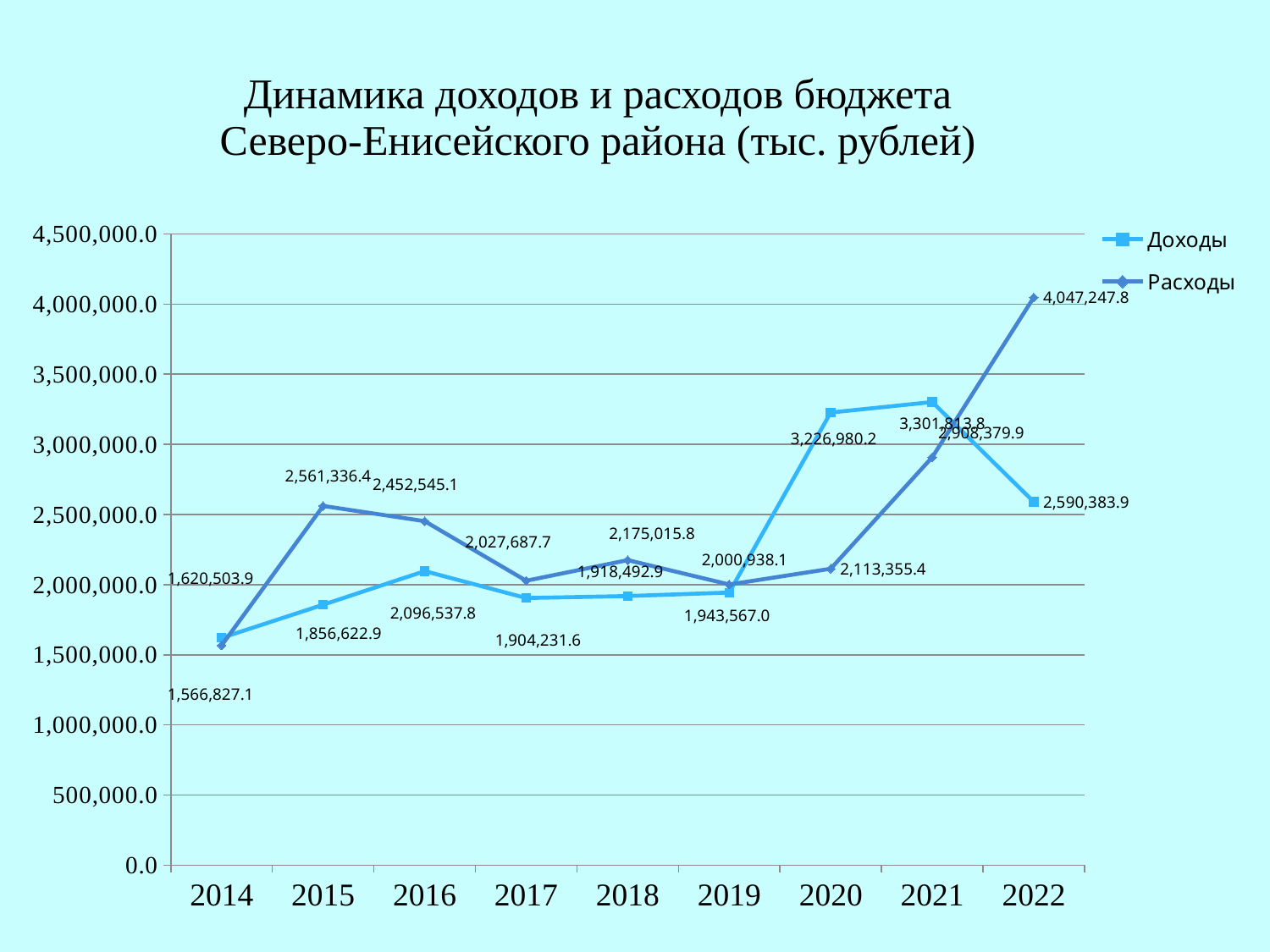
How many series does the legend list? 2 What kind of chart is shown on the slide? Line chart What is the value of Доходы in 2020? 3,226,980.2 How many years are plotted along the x axis? 9 What is the value of Расходы in 2015? 2,561,336.4 In which year is Доходы lowest? 2014 Does Расходы rise or fall from 2019 to 2022? Rises What is the difference between Расходы and Доходы in 2022? 1,456,863.9 What is the value of Расходы in 2022? 4,047,247.8 In 2015, which is larger, Доходы or Расходы? Расходы In which year is Расходы highest? 2022 Is the value of Расходы in 2021 greater or less than 3,000,000.0? less